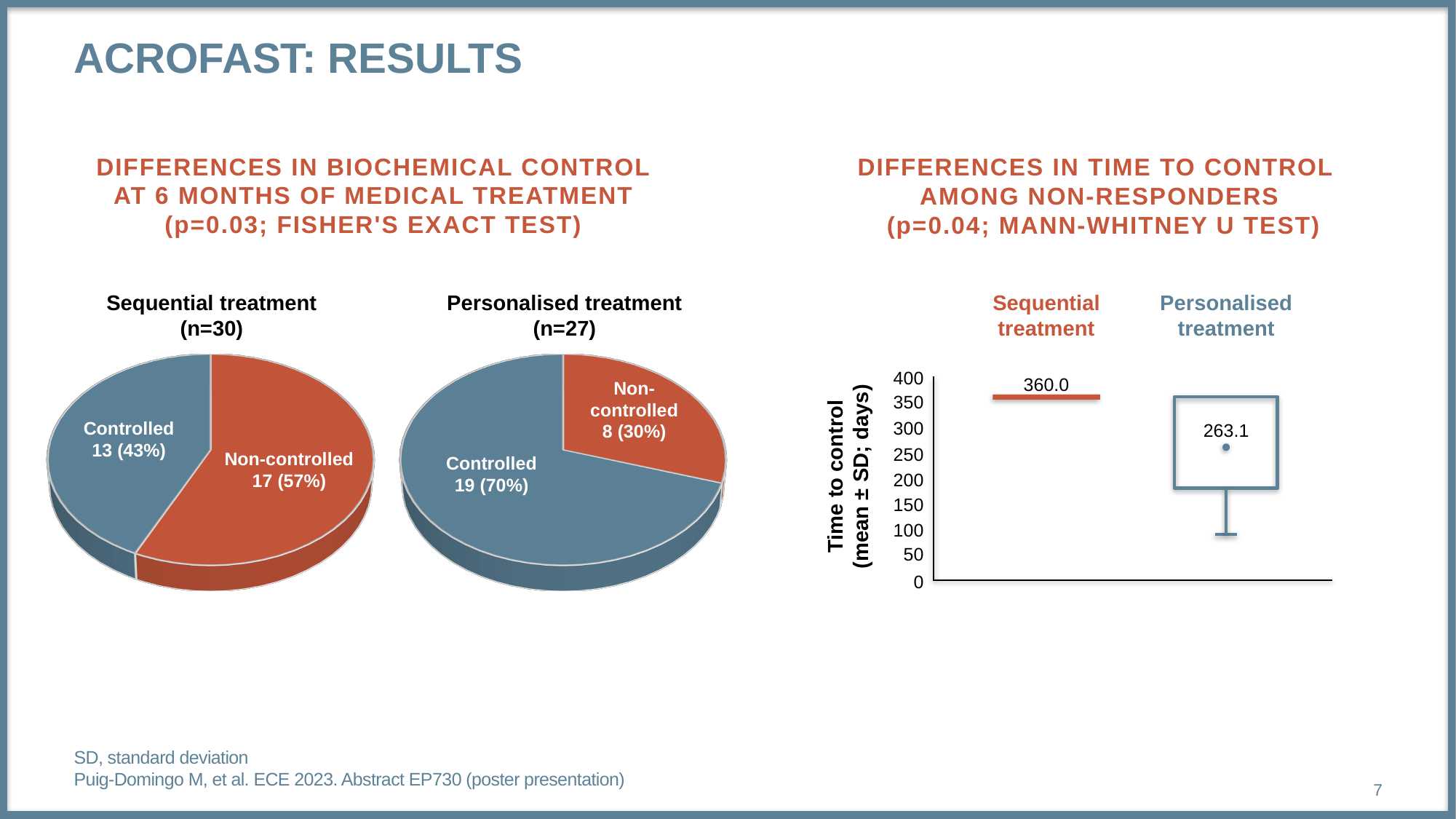
In the Sequential treatment (n=30) pie chart, how many patients were Controlled? 13 (43%) In the Sequential treatment (n=30) pie chart, what share of the pie is Non-controlled? 57% In the Sequential treatment (n=30) pie chart, what is the difference in patient count between Non-controlled and Controlled? 4 How many slices does the Personalised treatment (n=27) pie chart have? 2 In the 'Differences in time to control among non-responders' chart, what is the difference between the Sequential and Personalised mean times to control? 96.9 In the Personalised treatment (n=27) pie chart, which slice is larger, Controlled or Non-controlled? Controlled What kind of chart is used to show differences in biochemical control at 6 months? Pie chart In the Sequential treatment (n=30) pie chart, which slice is the largest? Non-controlled In the 'Differences in time to control among non-responders' chart, what is the mean time to control for Sequential treatment? 360.0 In the Personalised treatment (n=27) pie chart, how many patients were Non-controlled? 8 (30%) In the Personalised treatment (n=27) pie chart, what share of the pie is Controlled? 70% In the 'Differences in time to control among non-responders' chart, what is the mean time to control for Personalised treatment? 263.1